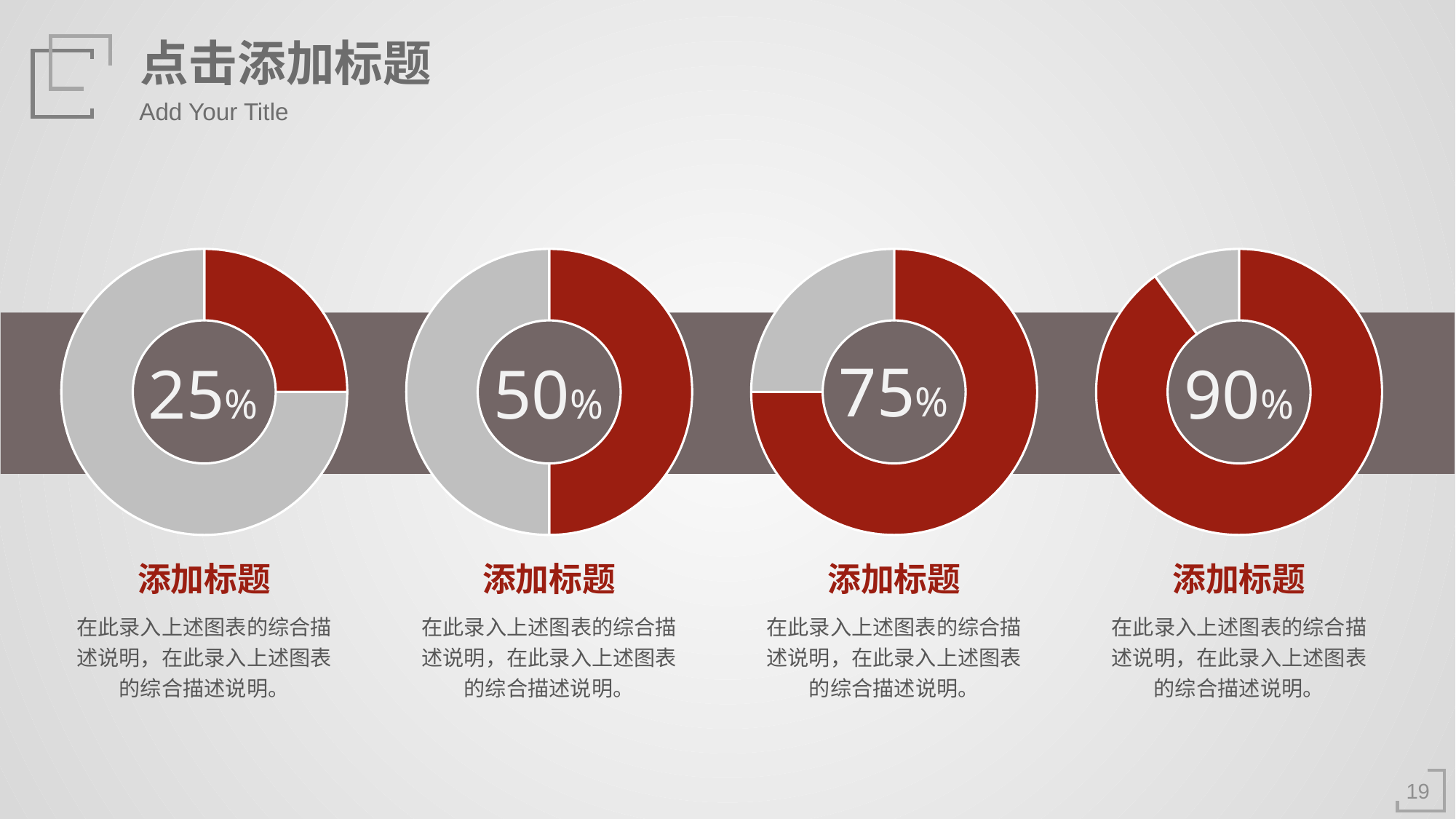
What percentage is shown in the centre of the rightmost doughnut chart? 90% What colour is the filled (completed) portion of each doughnut chart? Red What percentage is shown in the centre of the second doughnut chart from the left? 50% Which doughnut chart shows the highest percentage, by position on the slide? The rightmost chart (90%) What percentage is shown in the centre of the leftmost doughnut chart? 25% What is the difference between the percentage in the rightmost doughnut chart and the percentage in the leftmost doughnut chart? 65% What kind of chart is used for each of the four figures on the slide? Doughnut chart What percentage is shown in the centre of the third doughnut chart from the left? 75% Do the percentages in the doughnut charts increase or decrease from left to right across the slide? Increase Which doughnut chart shows the lowest percentage, by position on the slide? The leftmost chart (25%) Which is larger: the percentage in the second doughnut chart from the left or the percentage in the third doughnut chart from the left? The third chart (75%) How many doughnut charts are on the slide? 4